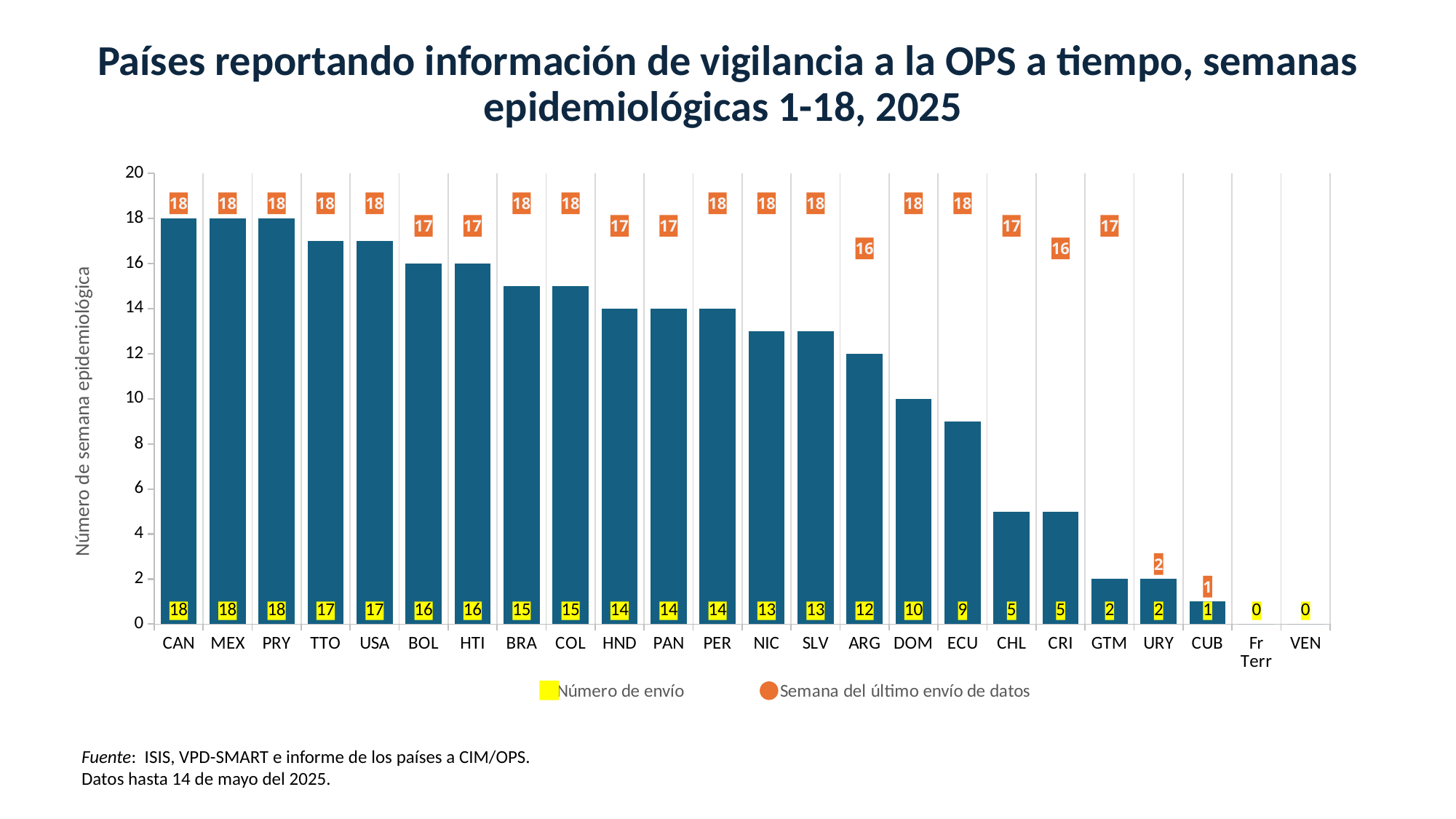
How many series does the legend list? 2 What is the 'Semana del último envío de datos' value for ARG? 16 Is the 'Número de envío' value for HND greater or less than 10? greater What is the 'Número de envío' value for ECU? 9 Which country has the lowest 'Número de envío' among those with a non-zero bar? CUB What is the 'Semana del último envío de datos' value for URY? 2 How many countries/territories are shown on the x axis? 24 What kind of chart is shown on the slide? Bar chart What is the difference in 'Número de envío' between CAN and DOM? 8 Which has a larger 'Número de envío', NIC or CHL? NIC What is the 'Número de envío' value for BRA? 15 Do the 'Número de envío' values rise or fall from left to right along the x axis? Fall